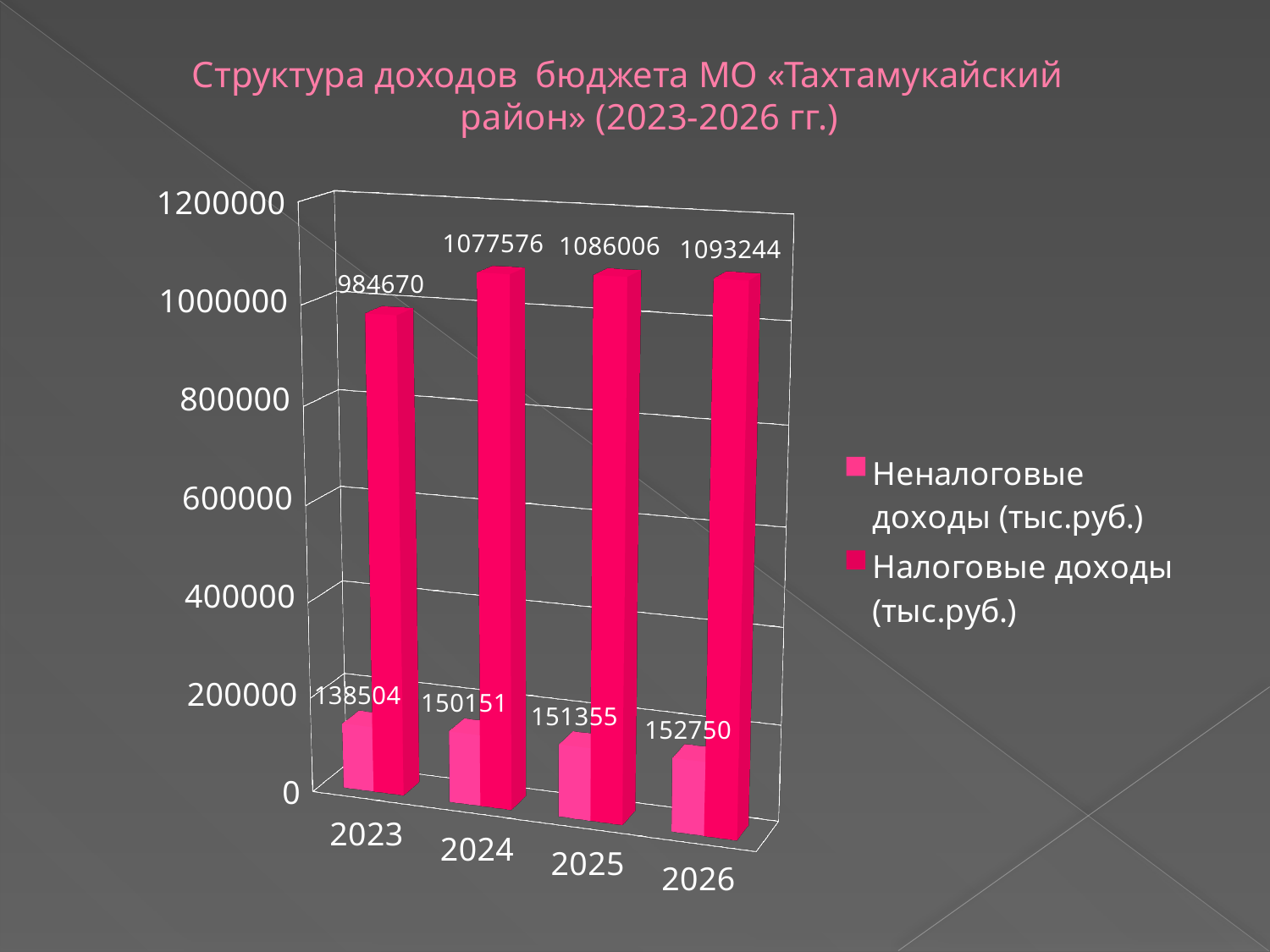
What is the difference between Налоговые доходы (тыс.руб.) in 2026 and in 2023? 108574 What kind of chart is shown on the slide? bar chart What is the value of Налоговые доходы (тыс.руб.) for 2023? 984670 What is the value of Неналоговые доходы (тыс.руб.) for 2026? 152750 Do the values of Налоговые доходы (тыс.руб.) rise or fall from 2023 to 2026? rise What is the value of Неналоговые доходы (тыс.руб.) for 2024? 150151 How many years are shown on the x axis? 4 Is the value of Налоговые доходы (тыс.руб.) for 2024 greater or less than 1000000? greater How many series does the legend list? 2 In which year is Налоговые доходы (тыс.руб.) highest? 2026 In which year is Неналоговые доходы (тыс.руб.) lowest? 2023 Which is larger in 2025: Налоговые доходы (тыс.руб.) or Неналоговые доходы (тыс.руб.)? Налоговые доходы (тыс.руб.)